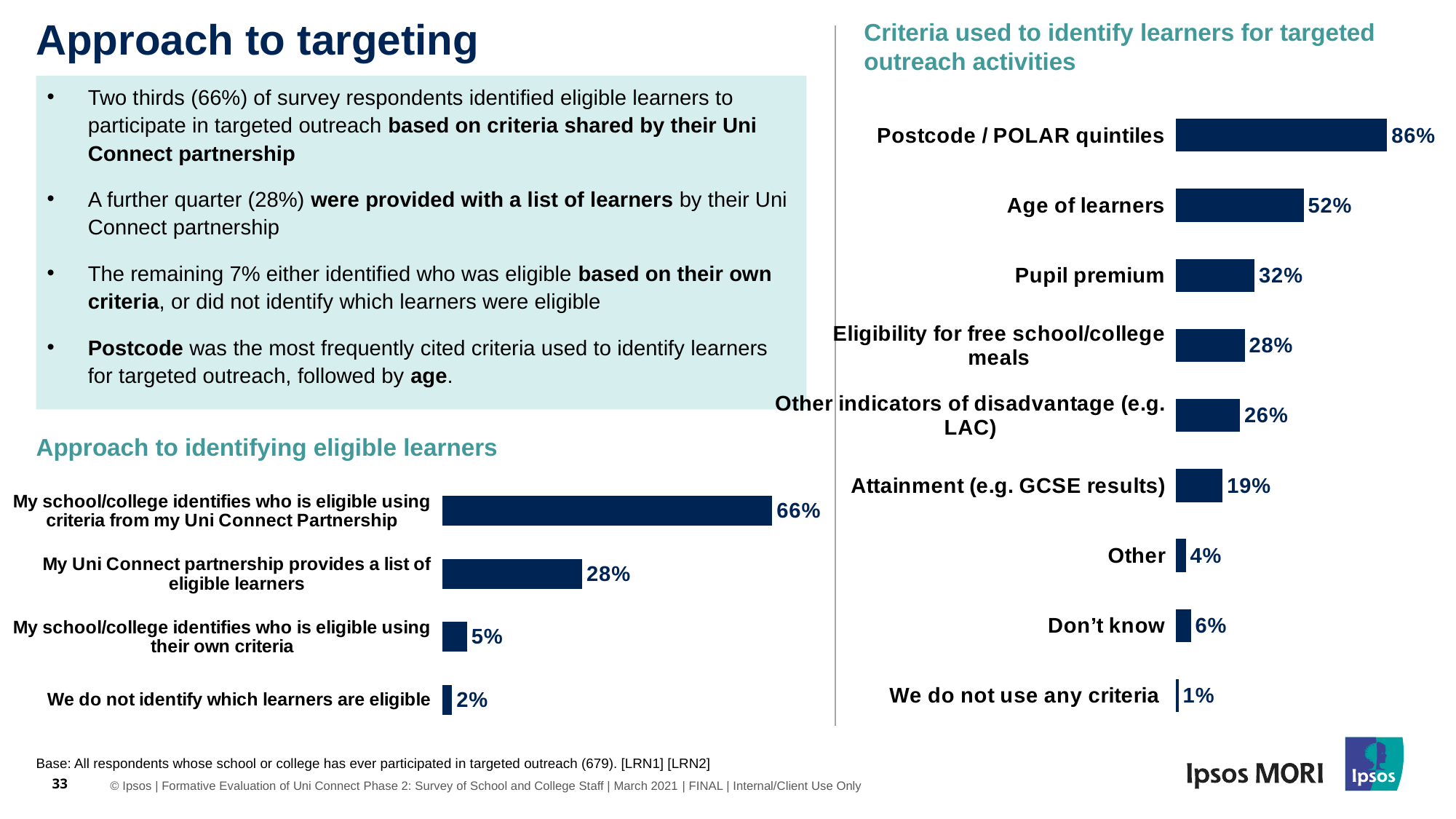
In the 'Criteria used to identify learners for targeted outreach activities' chart, how many categories are shown? 9 In the 'Approach to identifying eligible learners' chart, what is the difference between the values for 'My school/college identifies who is eligible using criteria from my Uni Connect Partnership' and 'My Uni Connect partnership provides a list of eligible learners'? 38 percentage points In the 'Criteria used to identify learners for targeted outreach activities' chart, which category has the lowest value? We do not use any criteria In the 'Approach to identifying eligible learners' chart, which category has the lowest value? We do not identify which learners are eligible In the 'Criteria used to identify learners for targeted outreach activities' chart, what percentage is shown for 'Pupil premium'? 32% In the 'Approach to identifying eligible learners' chart, what percentage is shown for 'My Uni Connect partnership provides a list of eligible learners'? 28% In the 'Criteria used to identify learners for targeted outreach activities' chart, which criterion has the highest value? Postcode / POLAR quintiles In the 'Approach to identifying eligible learners' chart, how many categories are shown? 4 In the 'Approach to identifying eligible learners' chart, which category has the highest value? My school/college identifies who is eligible using criteria from my Uni Connect Partnership In the 'Criteria used to identify learners for targeted outreach activities' chart, which is larger: 'Eligibility for free school/college meals' or 'Other indicators of disadvantage (e.g. LAC)'? Eligibility for free school/college meals What type of chart is the 'Criteria used to identify learners for targeted outreach activities' chart? Bar chart In the 'Criteria used to identify learners for targeted outreach activities' chart, what percentage is shown for 'Attainment (e.g. GCSE results)'? 19%